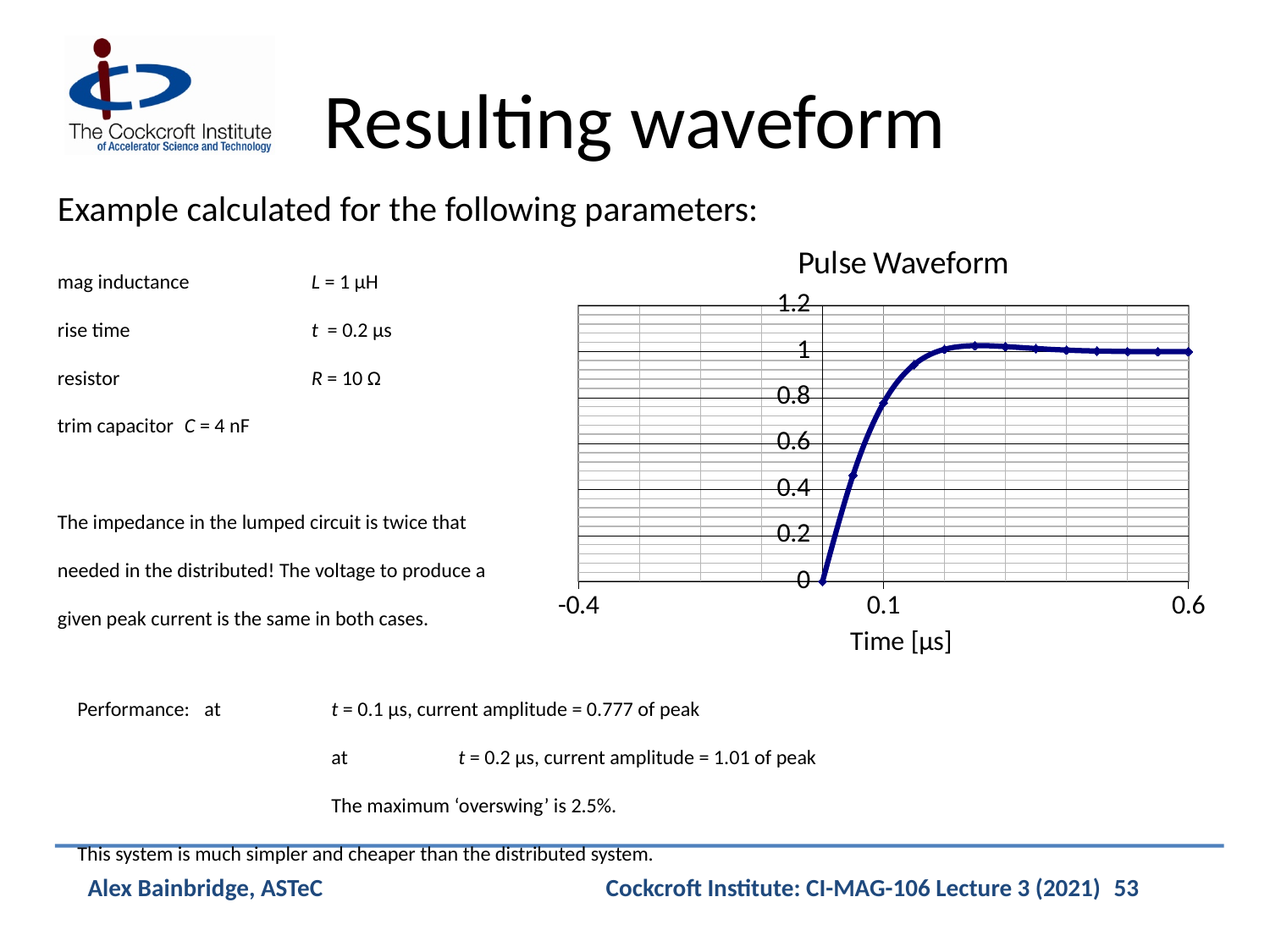
What is the highest value shown on the y-axis of the Pulse Waveform chart? 1.2 In the Pulse Waveform chart, is the value at Time = 0.6 greater or less than 1.2? less What is the title of the chart on the slide? Pulse Waveform In the Pulse Waveform chart, does the waveform rise or fall as time increases from 0 to 0.1 µs? rise What is the x-axis title of the Pulse Waveform chart? Time [µs] In the Pulse Waveform chart, is the value at Time = 0.6 greater or less than 0.8? greater In the Pulse Waveform chart, is the value at Time = 0.1 greater or less than 0.6? greater In the Pulse Waveform chart, is the value at Time = 0.6 larger or smaller than the value at Time = 0? larger What type of chart is the Pulse Waveform chart? line chart